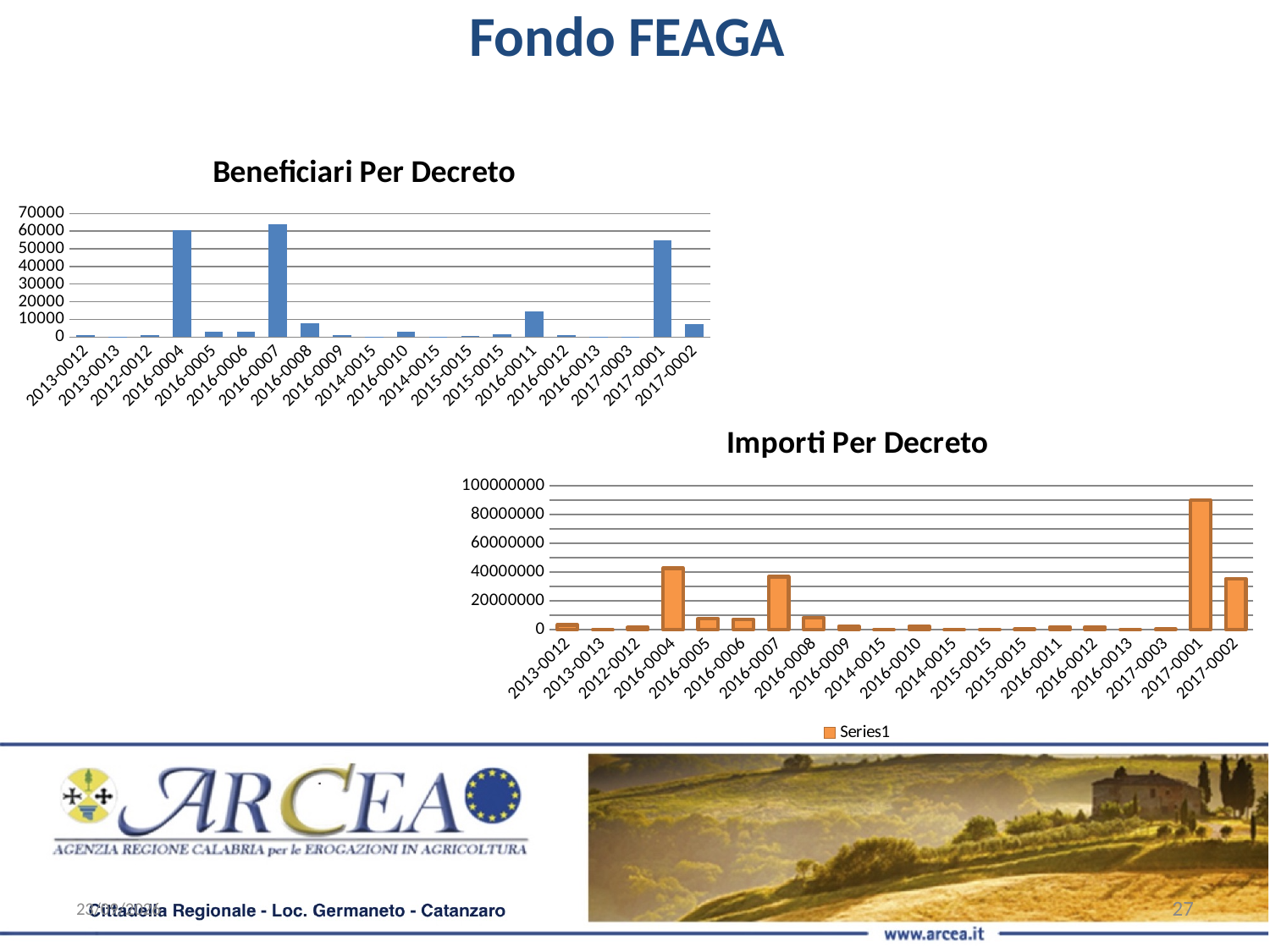
In the "Beneficiari Per Decreto" chart, which is larger, the value for 2017-0001 or the value for 2017-0002? 2017-0001 In the "Importi Per Decreto" chart, which decree has the highest amount? 2017-0001 In the "Importi Per Decreto" chart, is the value for 2017-0001 greater or less than 80000000? greater In the "Beneficiari Per Decreto" chart, is the value for 2016-0011 greater or less than 10000? greater What is the name of the series shown in the legend of the "Importi Per Decreto" chart? Series1 In the "Importi Per Decreto" chart, which is larger, the value for 2016-0004 or the value for 2016-0005? 2016-0004 In the "Beneficiari Per Decreto" chart, is the value for 2017-0001 greater or less than 50000? greater In the "Beneficiari Per Decreto" chart, which decree has the highest number of beneficiaries? 2016-0007 What kind of chart is the "Beneficiari Per Decreto" chart? bar chart How many series does the legend of the "Importi Per Decreto" chart list? 1